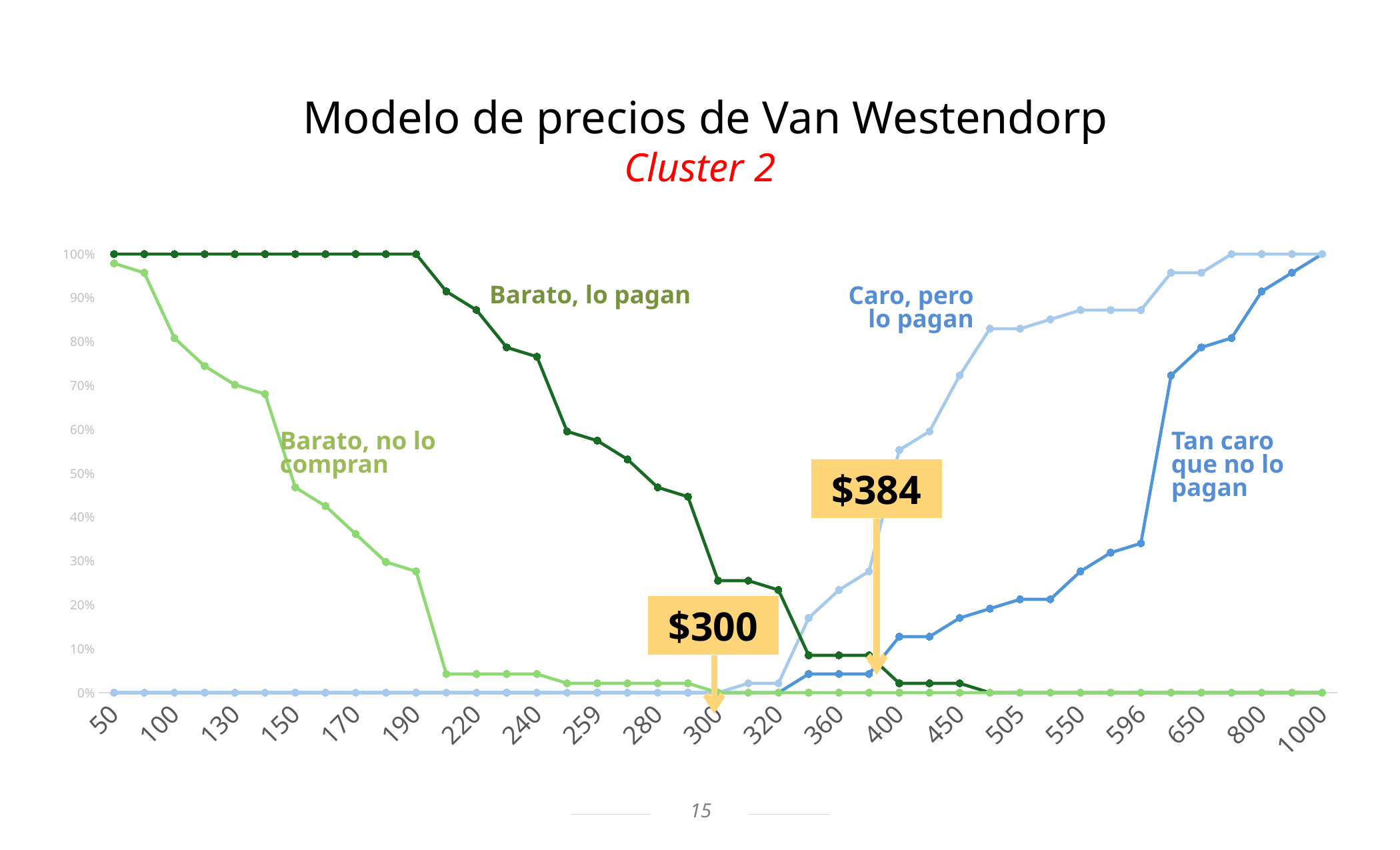
How many price points are labelled along the x axis? 21 Is the value for 'Barato, lo pagan' at a price of 240 greater or less than 70%? greater What two prices are highlighted with yellow callout boxes on the chart? $300 and $384 Does the 'Tan caro que no lo pagan' line rise or fall as price increases along the x axis? Rises Does the 'Barato, lo pagan' line rise or fall as price increases along the x axis? Falls What is the value of 'Barato, no lo compran' at a price of 1000? 0% What kind of chart is shown on the slide? Line chart What is the value of 'Barato, lo pagan' at a price of 50? 100% Is the value for 'Tan caro que no lo pagan' at a price of 596 greater or less than 30%? greater How many series (lines) are plotted on the chart? 4 What is the value of 'Tan caro que no lo pagan' at a price of 1000? 100% Is the value for 'Barato, no lo compran' at a price of 170 greater or less than 40%? less